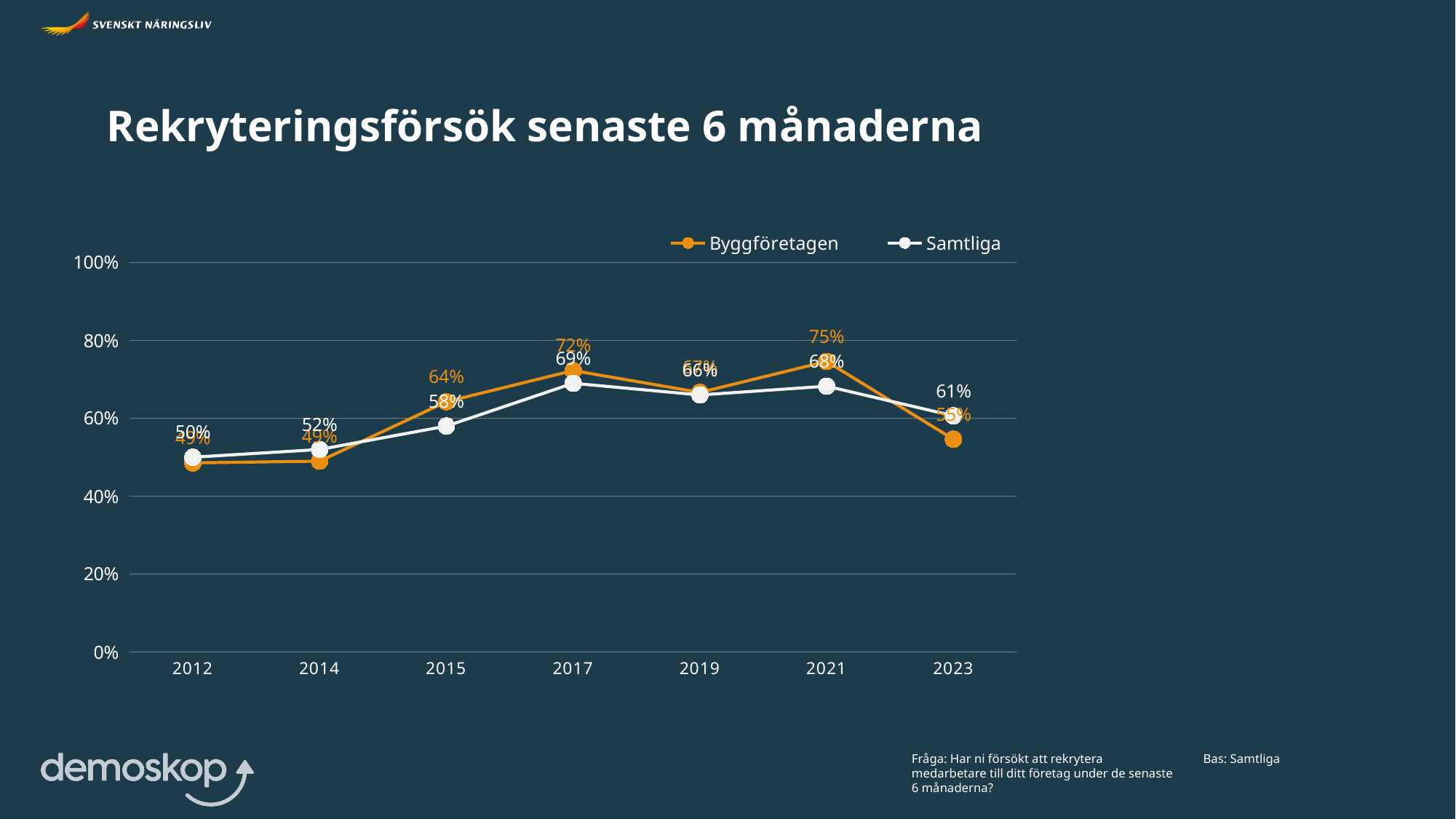
In which year does Byggföretagen reach its highest value? 2021 How many years are plotted along the x axis? 7 What is the value for Byggföretagen in 2021? 75% What is the value for Byggföretagen in 2017? 72% What is the value for Samtliga in 2012? 50% Does the Samtliga line rise or fall from 2012 to 2017? rise How many series does the legend list? 2 What kind of chart is shown on the slide? line chart In 2015, which series has the higher value, Byggföretagen or Samtliga? Byggföretagen What is the difference between Byggföretagen and Samtliga in 2021? 7 percentage points In which year is the Samtliga value lowest? 2012 What is the value for Samtliga in 2015? 58%